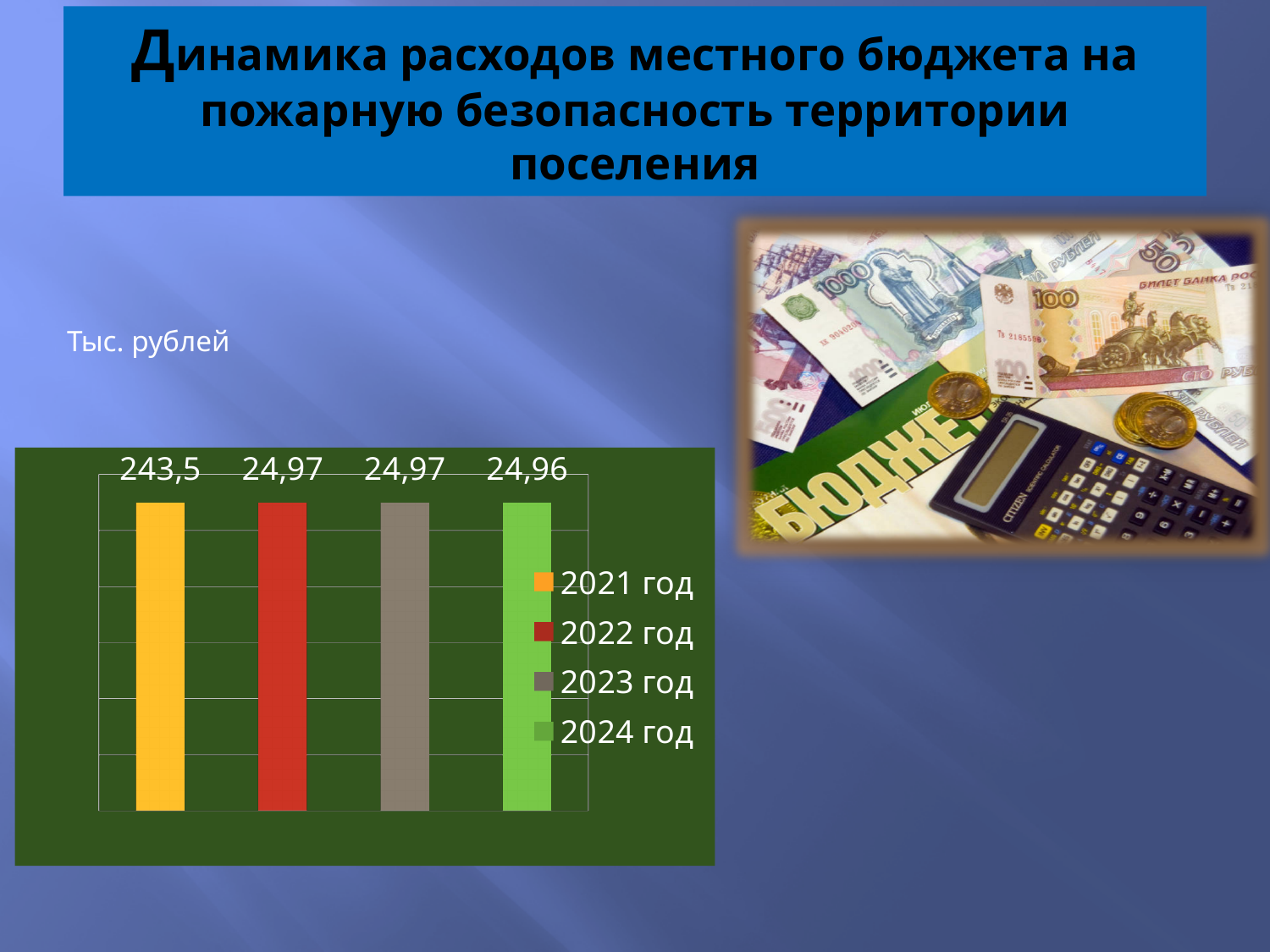
What is the value for 2021 год? 243,5 How many entries does the legend list? 4 Which is larger, the value for 2021 год or the value for 2024 год? 2021 год How many bars are plotted in the chart? 4 What is the value for 2022 год? 24,97 What is the difference between the values for 2021 год and 2022 год? 218,53 What unit is stated for the chart values? Тыс. рублей What is the value for 2023 год? 24,97 What is the difference between the values for 2023 год and 2024 год? 0,01 What kind of chart is shown on the slide? bar chart Which year has the highest value according to the data labels? 2021 год What is the value for 2024 год? 24,96